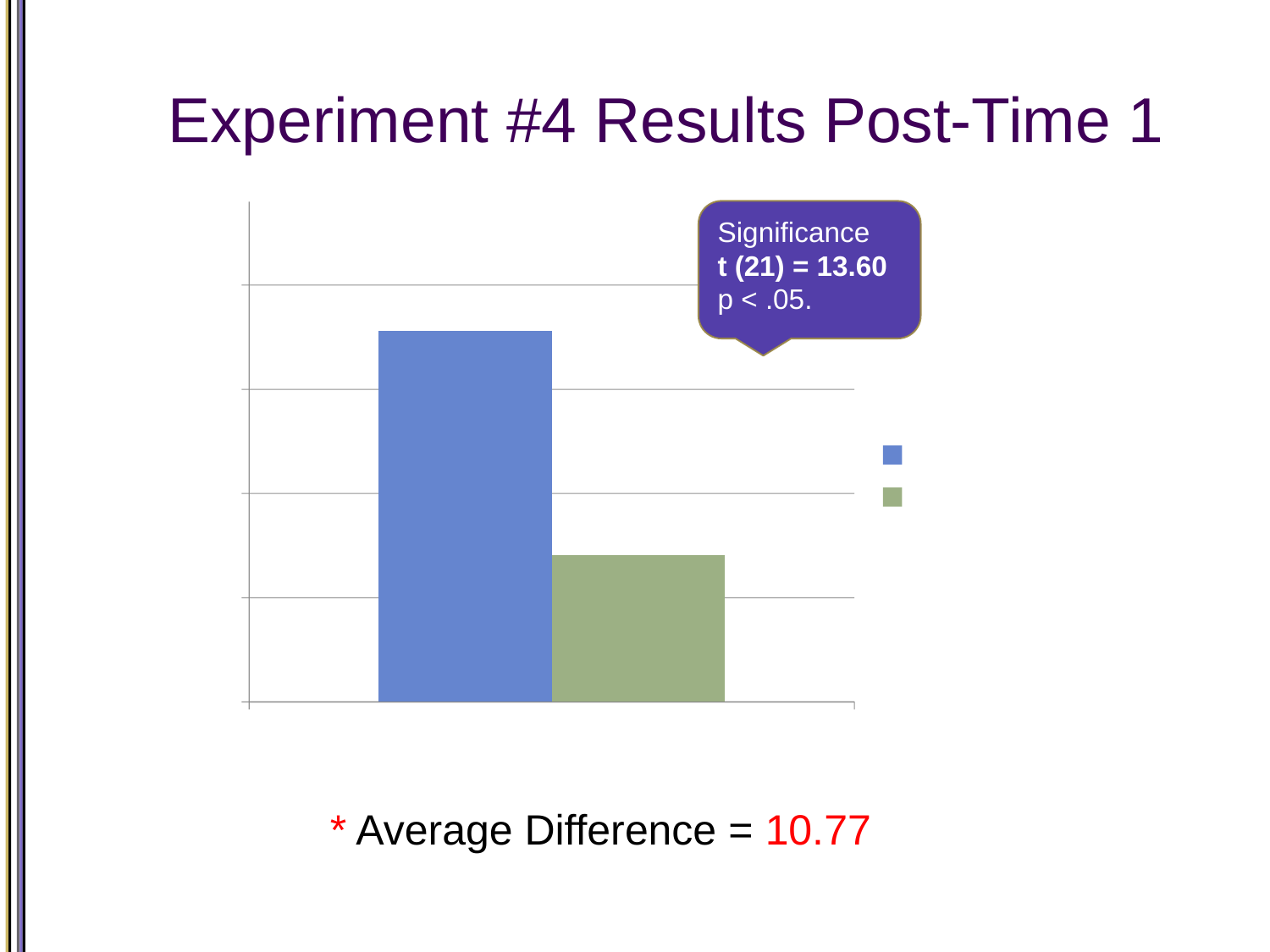
How many series does the chart's legend list? 2 Which bar has the highest value in the chart? the blue bar What colours are the two bars in the chart? blue and green Which bar is taller, the blue bar or the green bar? the blue bar How many bars are plotted in the chart? 2 What kind of chart is shown on the slide? bar chart What t statistic is reported in the callout box on the chart? t (21) = 13.60 Which bar has the lowest value in the chart? the green bar